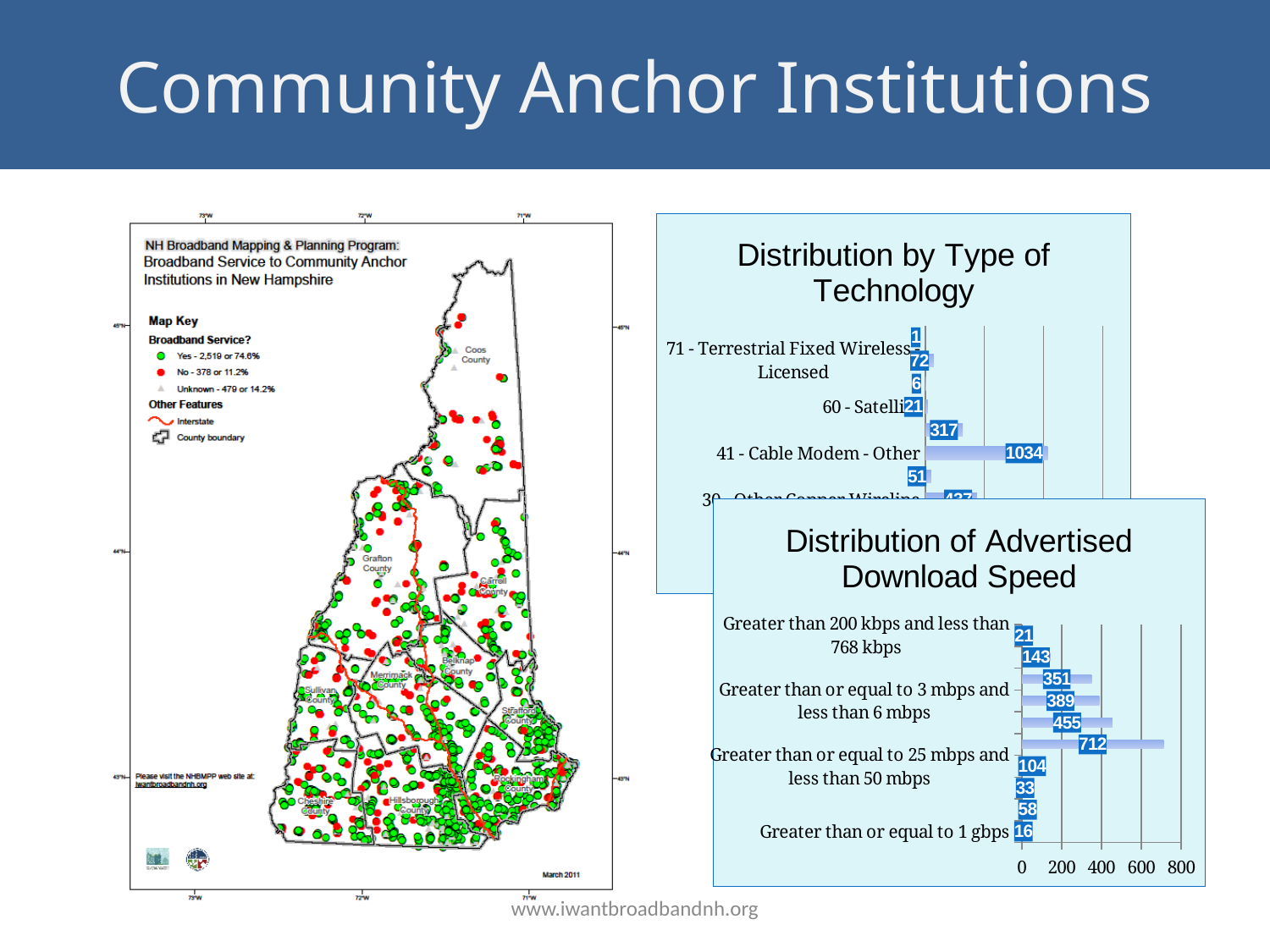
What kind of chart is the Distribution of Advertised Download Speed chart? Bar chart In the Distribution of Advertised Download Speed chart, what is the largest value shown on any bar? 712 In the Distribution of Advertised Download Speed chart, what is the smallest value shown on any bar? 16 How many bars are plotted in the Distribution of Advertised Download Speed chart? 10 In the Distribution by Type of Technology chart, what is the value for "60 - Satellite"? 21 In the Distribution of Advertised Download Speed chart, what is the value for "Greater than or equal to 1 gbps"? 16 In the Distribution by Type of Technology chart, what is the value for "41 - Cable Modem - Other"? 1034 In the Distribution of Advertised Download Speed chart, what is the value for "Greater than or equal to 3 mbps and less than 6 mbps"? 389 In the Distribution by Type of Technology chart, which has the larger value: "41 - Cable Modem - Other" or "60 - Satellite"? 41 - Cable Modem - Other In the Distribution of Advertised Download Speed chart, what is the value for "Greater than 200 kbps and less than 768 kbps"? 21 In the Distribution of Advertised Download Speed chart, what is the value for "Greater than or equal to 25 mbps and less than 50 mbps"? 104 In the Distribution of Advertised Download Speed chart, what is the difference between the value for "Greater than or equal to 3 mbps and less than 6 mbps" and the value for "Greater than or equal to 25 mbps and less than 50 mbps"? 285